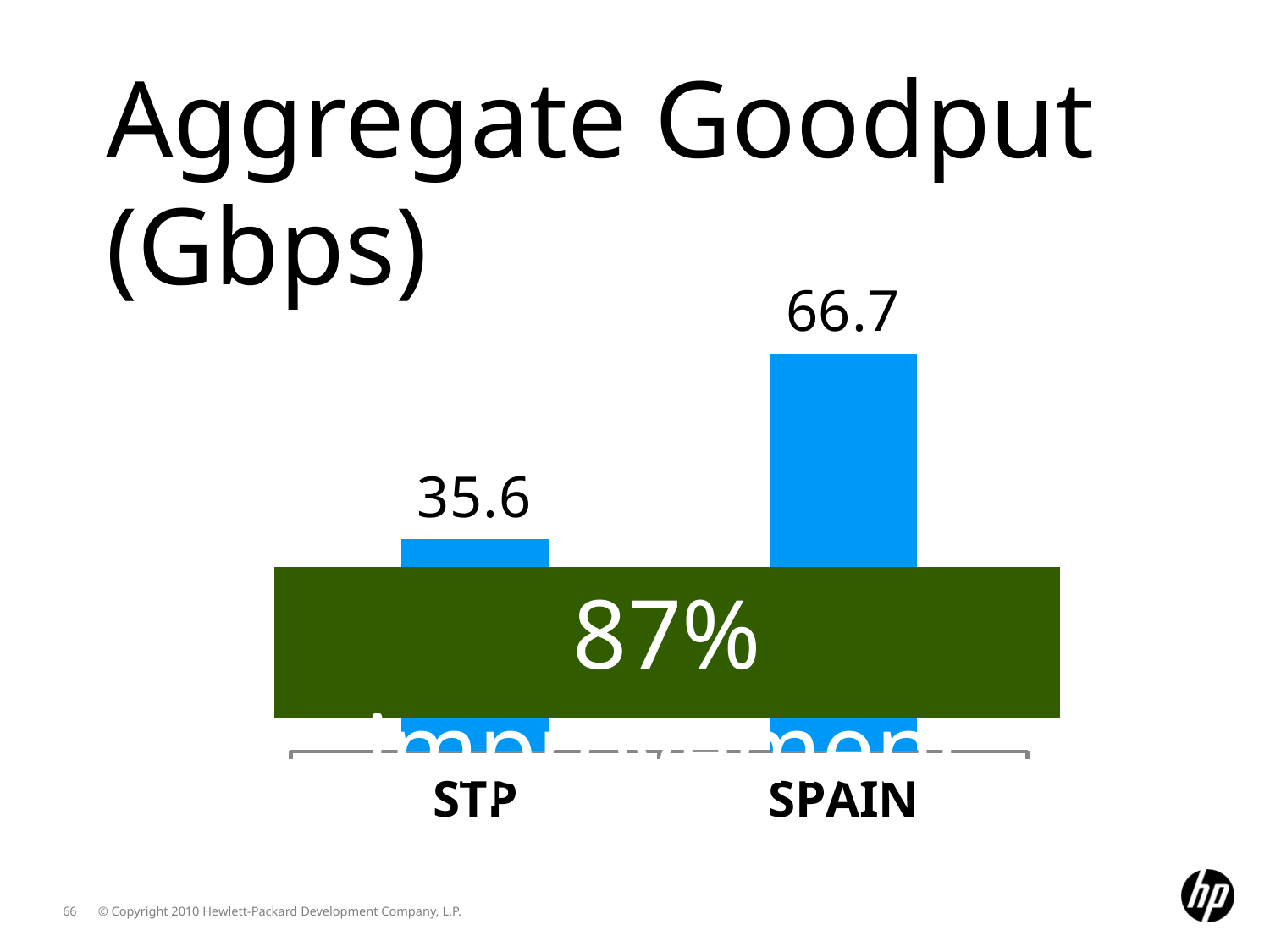
What unit is the aggregate goodput measured in? Gbps What is the difference between the aggregate goodput of SPAIN and STP? 31.1 What percentage improvement is shown in the green box overlaid on the chart? 87% What is the title of the chart? Aggregate Goodput (Gbps) What kind of chart is shown on the slide? bar chart How many categories are shown in the chart? 2 Which category has the highest aggregate goodput? SPAIN Which category has the lowest aggregate goodput? STP Which has a larger aggregate goodput, STP or SPAIN? SPAIN What is the aggregate goodput value for SPAIN? 66.7 What is the aggregate goodput value for STP? 35.6